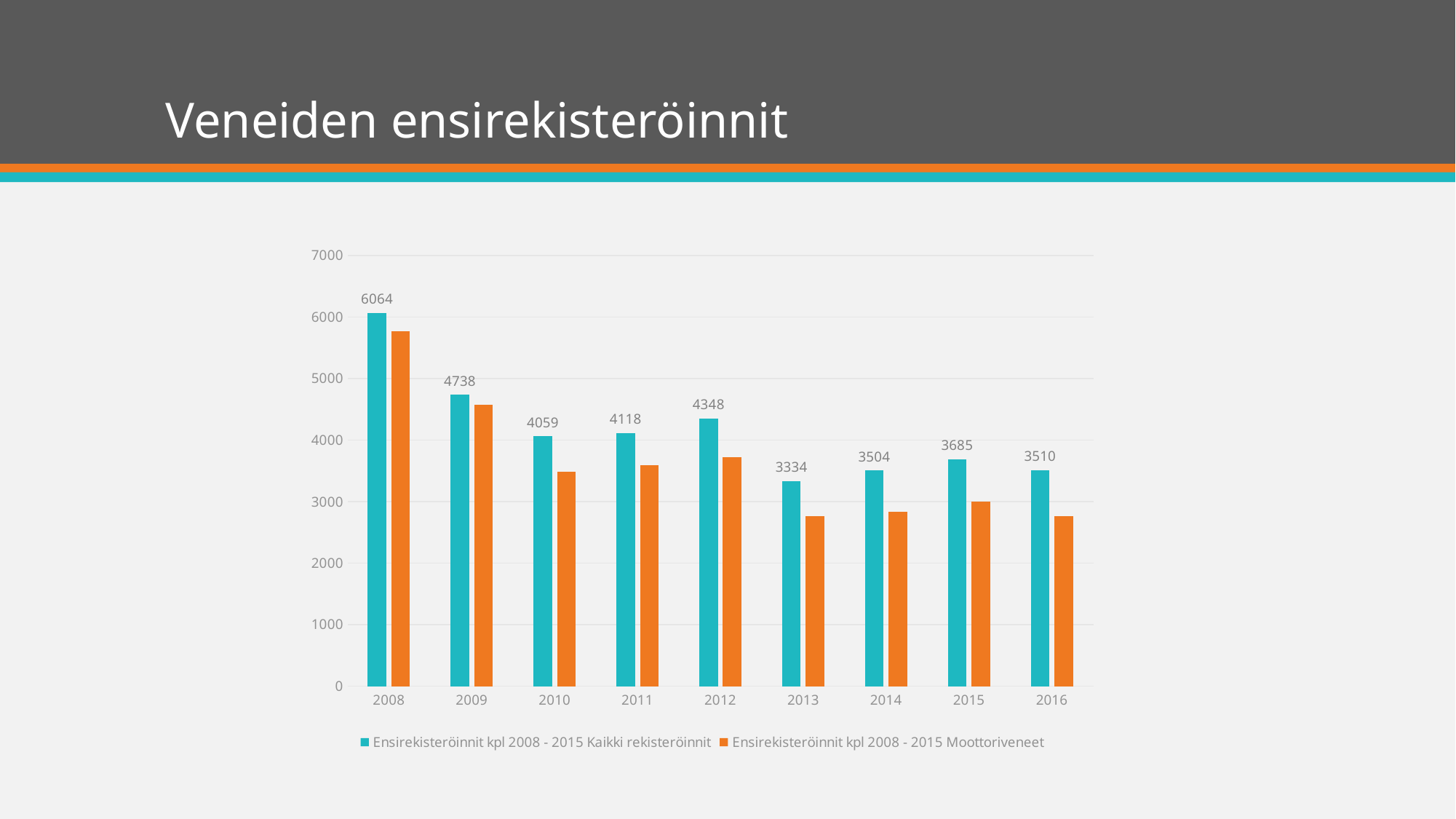
Is the value for Moottoriveneet in 2013 greater or less than 3000? less What kind of chart is shown on the slide? bar chart What is the value for Kaikki rekisteröinnit in 2008? 6064 How many series does the legend list? 2 What is the value for Kaikki rekisteröinnit in 2016? 3510 Which year has the lowest value for Kaikki rekisteröinnit? 2013 What is the difference between the Kaikki rekisteröinnit values for 2008 and 2009? 1326 Which is larger for Kaikki rekisteröinnit: 2011 or 2010? 2011 Is the value for Moottoriveneet in 2008 greater or less than 5000? greater How many years are shown on the x axis? 9 What is the value for Kaikki rekisteröinnit in 2012? 4348 Which year has the highest value for Kaikki rekisteröinnit? 2008